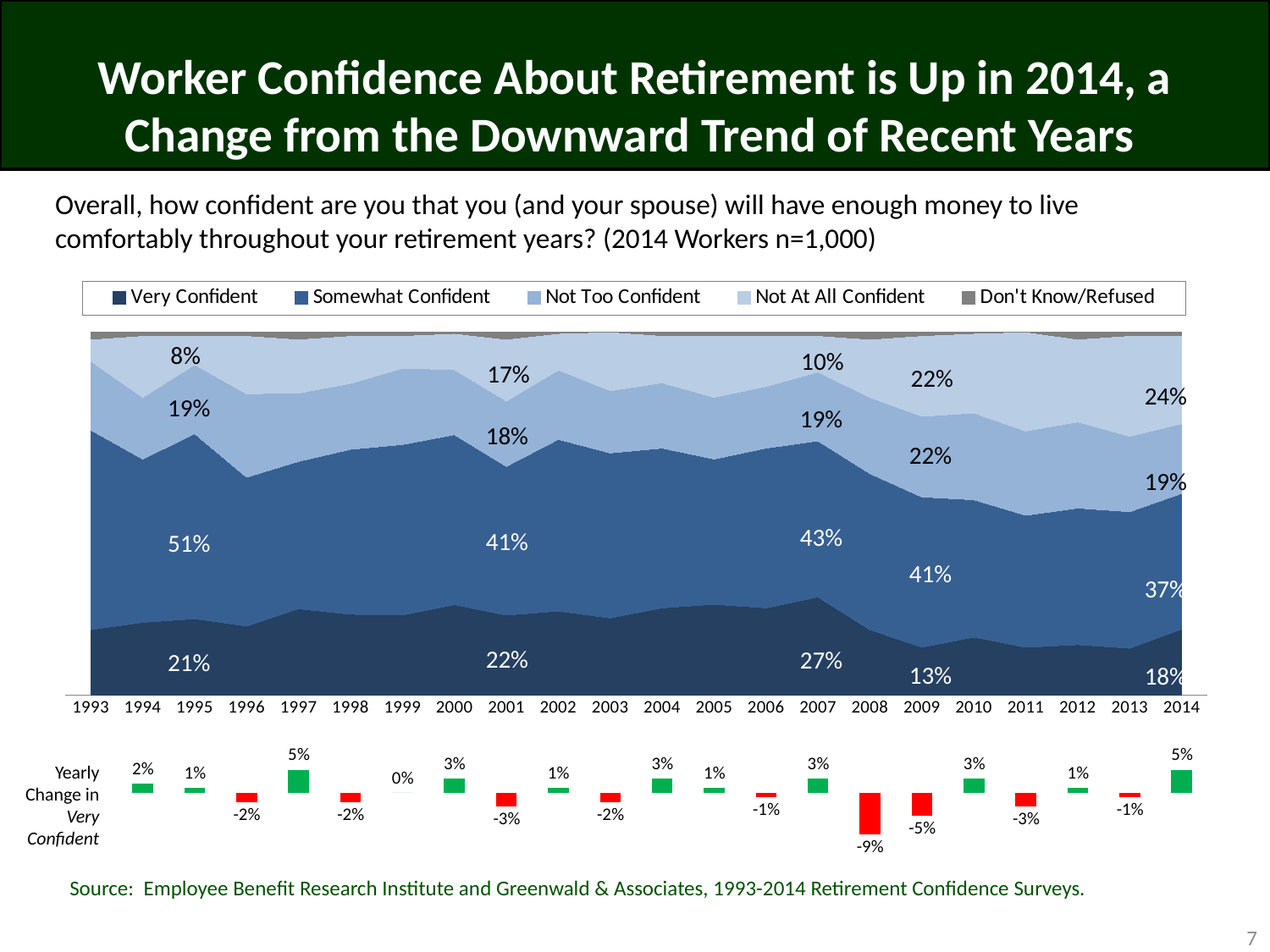
In the upper chart, what percentage of workers were Somewhat Confident in 2001? 41% In the lower 'Yearly Change in Very Confident' chart, what is the value for 2010? 3% In the upper chart, what percentage of workers were Not At All Confident in 2014? 24% In the upper chart, what percentage of workers were Very Confident in 2009? 13% In the upper chart, what percentage of workers were Very Confident in 2007? 27% In the lower 'Yearly Change in Very Confident' chart, which year shows the largest decline? 2008 In the upper chart, by how many percentage points did the Not At All Confident share change from 2007 (10%) to 2014 (24%)? 14 percentage points How many series does the legend of the upper chart list? 5 What kind of chart is the main (upper) chart on the slide? Stacked area chart How many years are shown on the x axis of the upper chart? 22 In the lower 'Yearly Change in Very Confident' chart, what is the value for 1999? 0% In the upper chart, was the Very Confident share larger in 2007 or in 2009? 2007